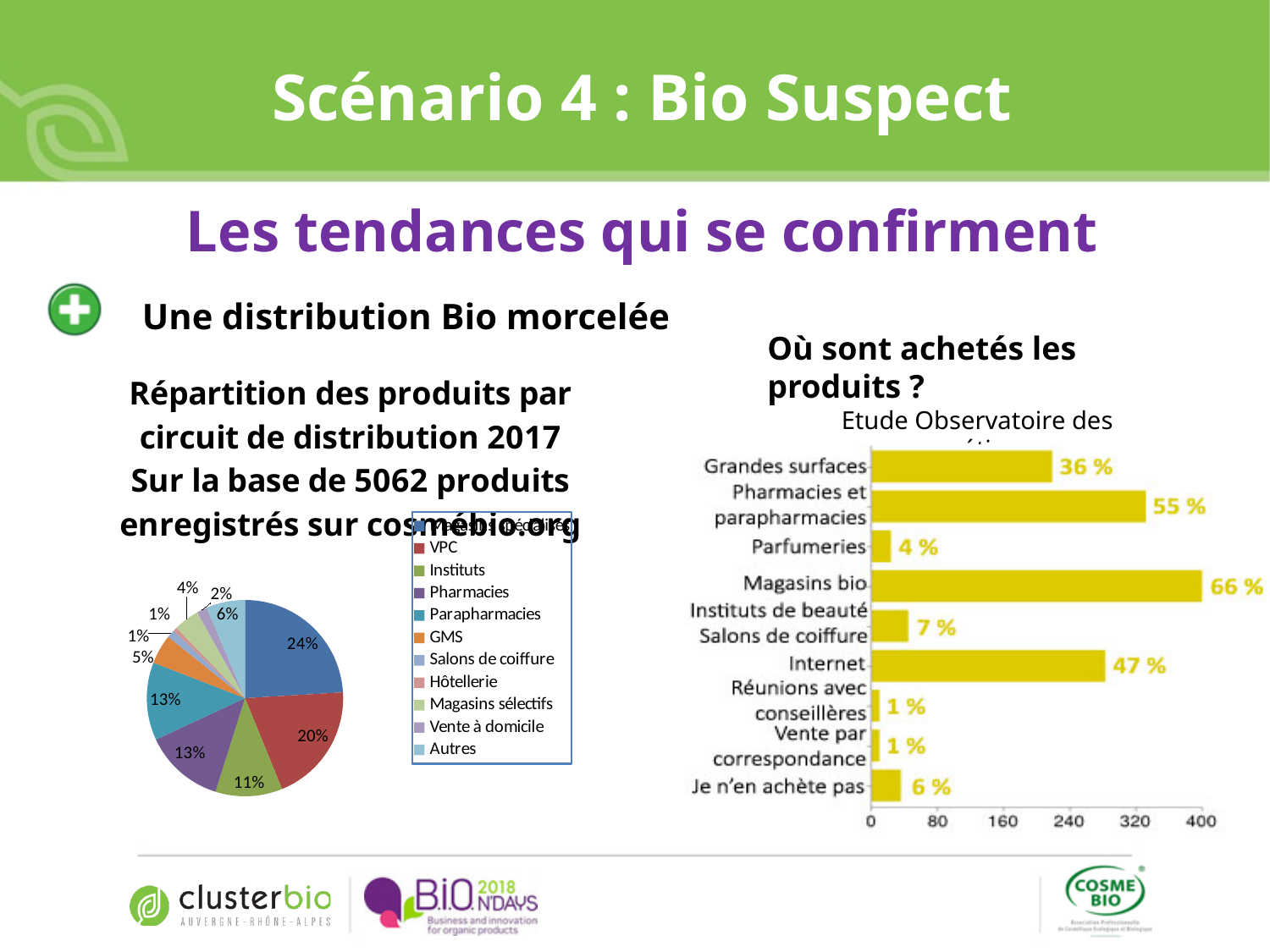
How many entries does the legend of the pie chart 'Répartition des produits par circuit de distribution 2017' list? 11 In the bar chart 'Où sont achetés les produits ?', what is the value for Magasins bio? 66 % In the pie chart 'Répartition des produits par circuit de distribution 2017', what is the share for Instituts? 11% In the bar chart 'Où sont achetés les produits ?', which is larger: Pharmacies et parapharmacies or Grandes surfaces? Pharmacies et parapharmacies What kind of chart is the chart on the right, 'Où sont achetés les produits ?'? bar chart In the bar chart 'Où sont achetés les produits ?', how many categories are shown? 9 In the pie chart 'Répartition des produits par circuit de distribution 2017', which is larger: VPC or Autres? VPC In the bar chart 'Où sont achetés les produits ?', what is the difference between the values for Magasins bio and Internet? 19 % In the bar chart 'Où sont achetés les produits ?', which category has the highest value? Magasins bio In the pie chart 'Répartition des produits par circuit de distribution 2017', what is the share for GMS? 5% In the pie chart 'Répartition des produits par circuit de distribution 2017', what is the share for VPC? 20% In the bar chart 'Où sont achetés les produits ?', what is the value for Internet? 47 %